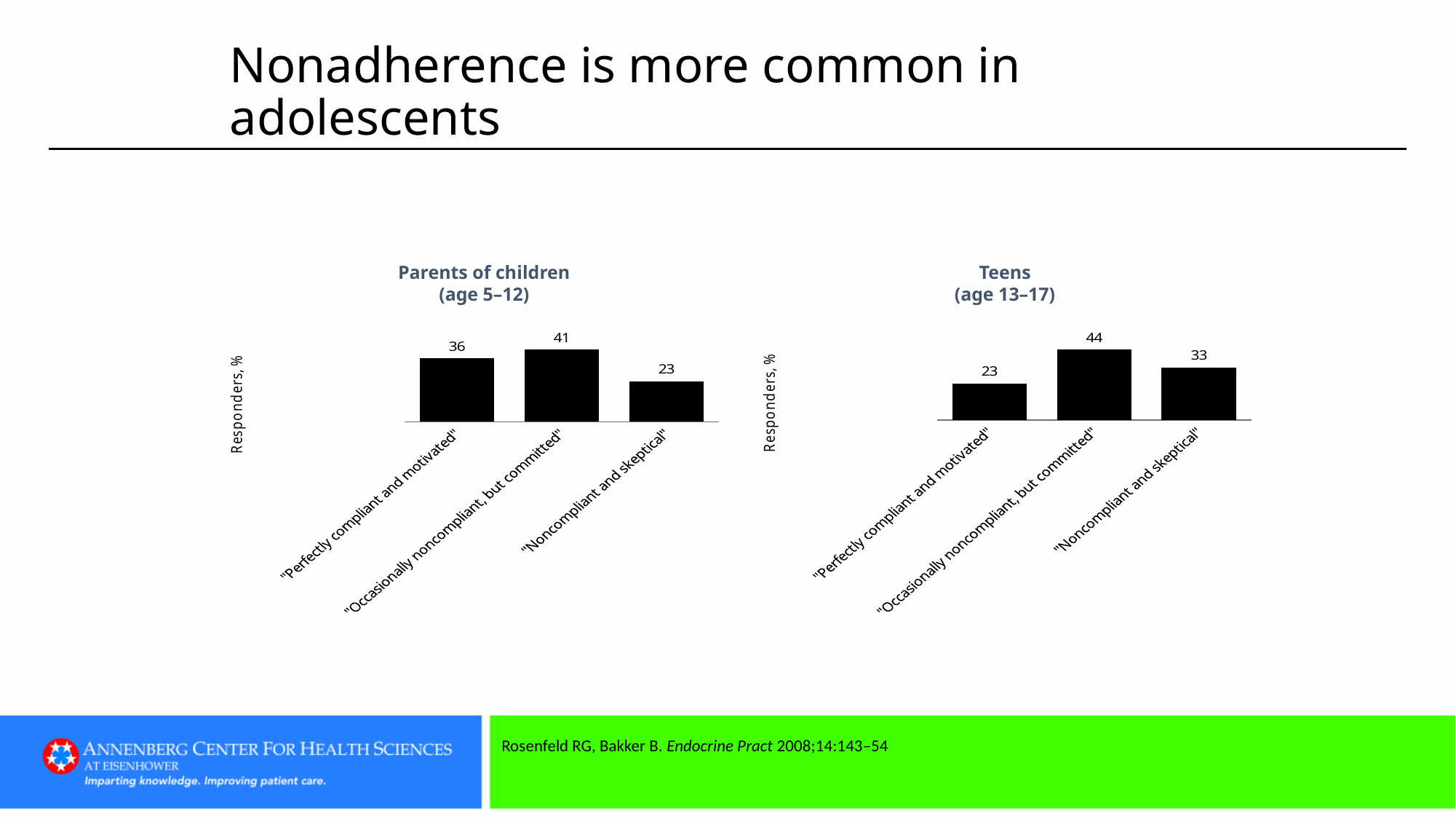
In the "Teens (age 13–17)" chart, what is the value for "Occasionally noncompliant, but committed"? 44 In the "Teens (age 13–17)" chart, which category has the lowest value? "Perfectly compliant and motivated" In the "Parents of children (age 5–12)" chart, which category has the highest value? "Occasionally noncompliant, but committed" How many categories are shown in the "Teens (age 13–17)" chart? 3 In the "Parents of children (age 5–12)" chart, what is the value for "Perfectly compliant and motivated"? 36 What is the y-axis label of the "Teens (age 13–17)" chart? Responders, % What is the difference between the "Noncompliant and skeptical" value in the "Teens (age 13–17)" chart and the same category in the "Parents of children (age 5–12)" chart? 10 In the "Parents of children (age 5–12)" chart, what is the difference between "Occasionally noncompliant, but committed" and "Noncompliant and skeptical"? 18 In the "Parents of children (age 5–12)" chart, what is the value for "Noncompliant and skeptical"? 23 Which is larger: "Perfectly compliant and motivated" in the "Parents of children (age 5–12)" chart or in the "Teens (age 13–17)" chart? Parents of children (age 5–12) What kind of chart is the "Parents of children (age 5–12)" chart? Bar chart In the "Teens (age 13–17)" chart, what is the value for "Noncompliant and skeptical"? 33